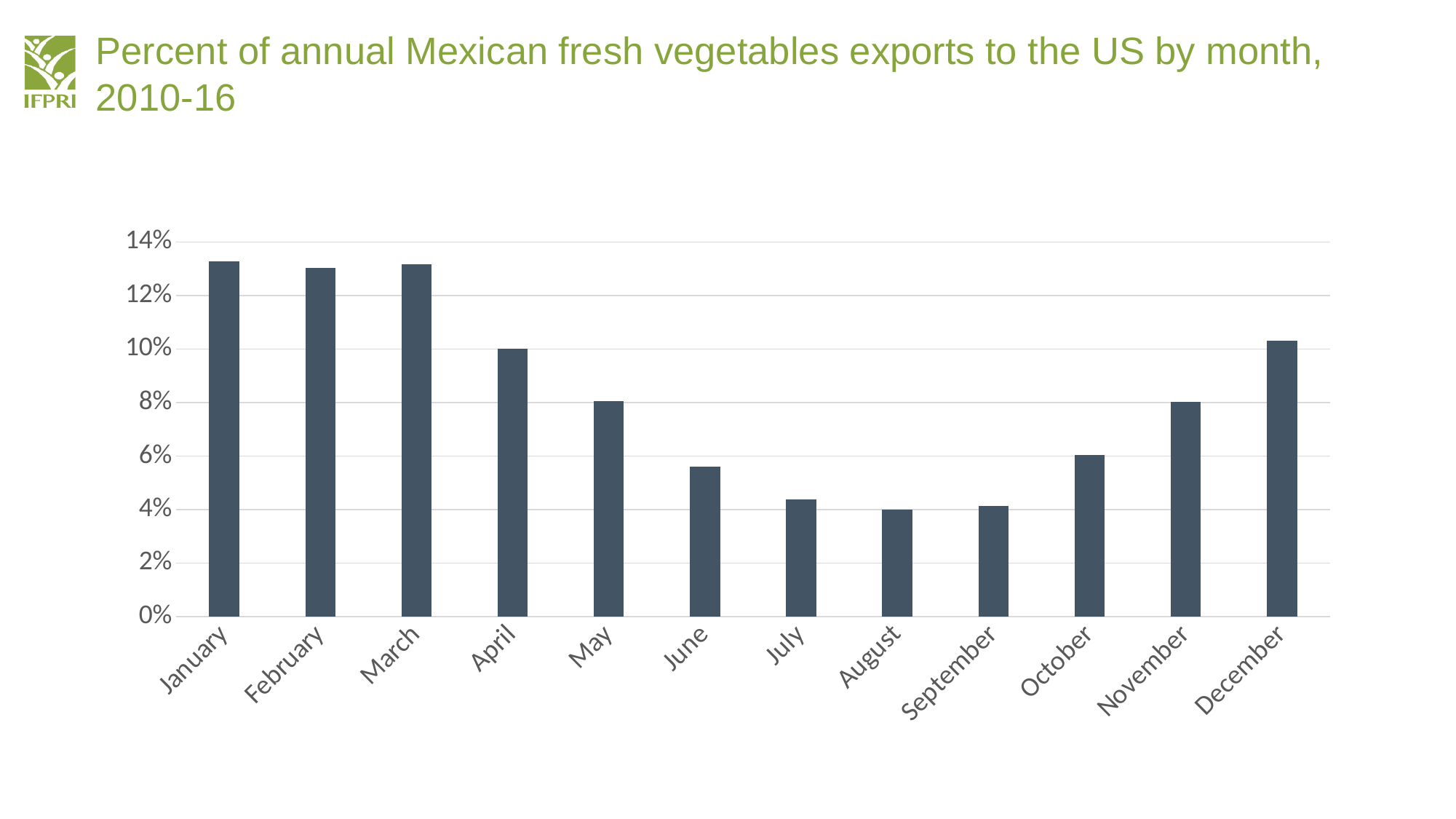
What kind of chart is shown on the slide? bar chart Which is larger, the value for July or the value for November? November Is the value for July greater or less than 4%? greater Is the value for January greater or less than 12%? greater Which is larger, the value for April or the value for May? April How many months are plotted on the chart? 12 What is the title of the chart? Percent of annual Mexican fresh vegetables exports to the US by month, 2010-16 Is the value for June greater or less than 6%? less Do the values rise or fall from January to August? fall Which is larger, the value for January or the value for December? January